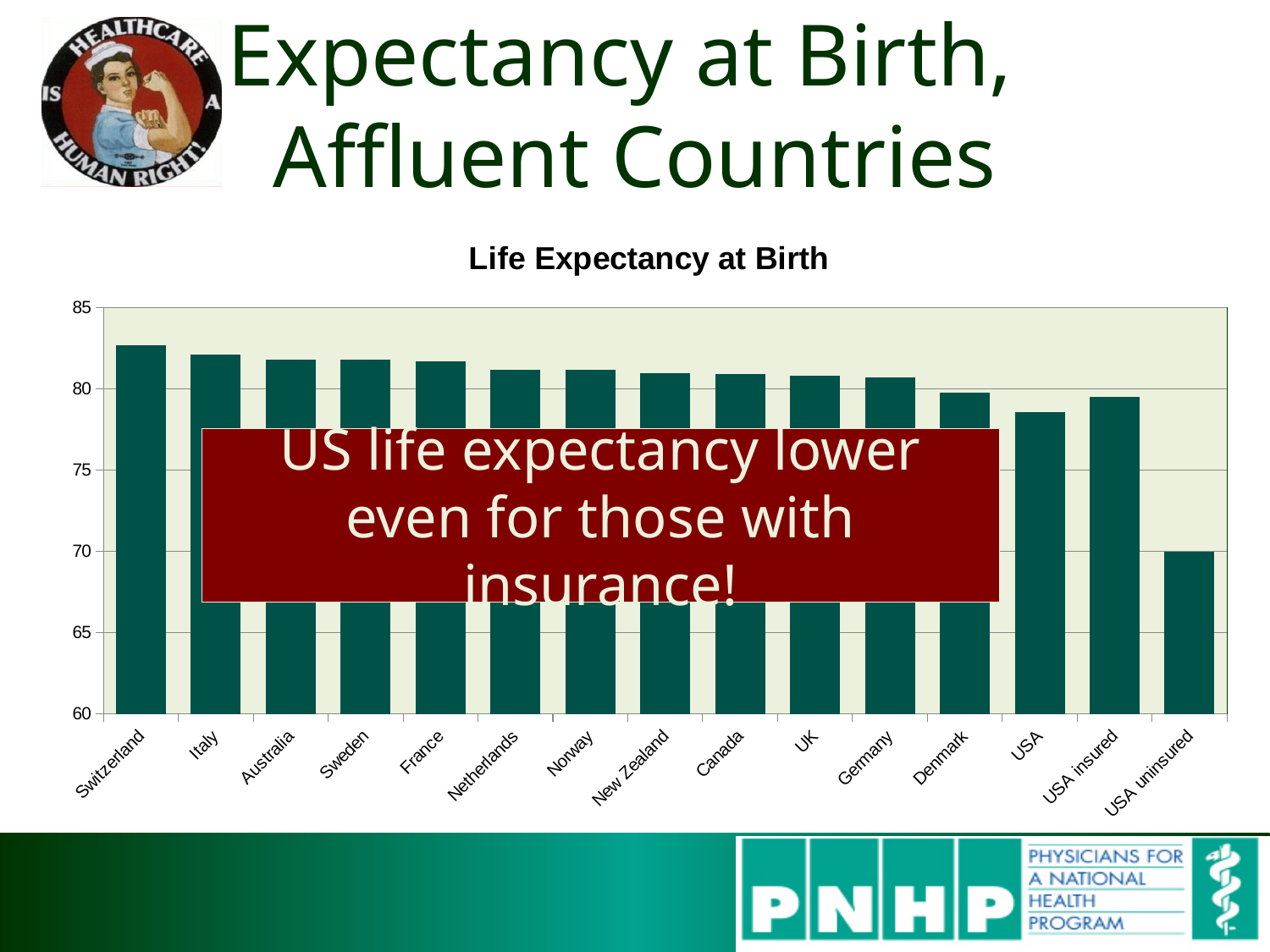
Is the value for USA greater or less than 80? less Which category has the highest life expectancy at birth? Switzerland What is the title of the chart? Life Expectancy at Birth Which has a higher life expectancy at birth, Switzerland or USA? Switzerland What kind of chart is shown on the slide? bar chart How many categories (bars) are plotted in the chart? 15 Which category has the lowest life expectancy at birth? USA uninsured Is the value for Switzerland greater or less than 80? greater Is the value for Italy greater or less than 80? greater Which has a higher life expectancy at birth, USA insured or USA uninsured? USA insured Do the values generally rise or fall along the x axis from Switzerland to USA? fall